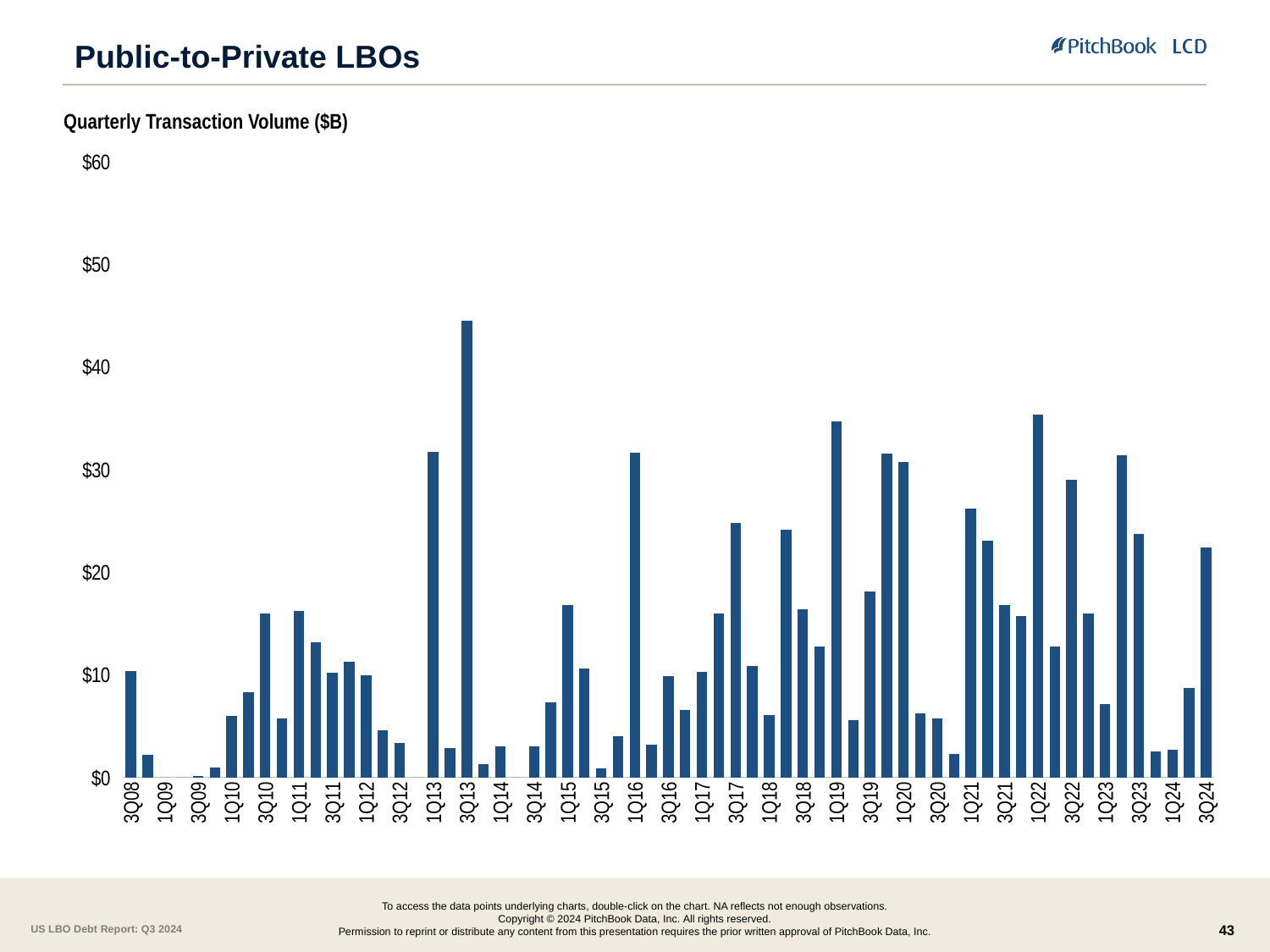
Is the value for 1Q21 greater or less than $20? greater Which is larger, the value for 1Q22 or the value for 3Q24? 1Q22 Which quarter has the highest transaction volume? 3Q13 Is the value for 1Q24 greater or less than $10? less What is the title of the chart? Quarterly Transaction Volume ($B) Is the value for 3Q13 greater or less than $40? greater What is the highest value shown on the y axis? $60 Which is larger, the value for 3Q13 or the value for 1Q19? 3Q13 What kind of chart is shown on the slide? bar chart